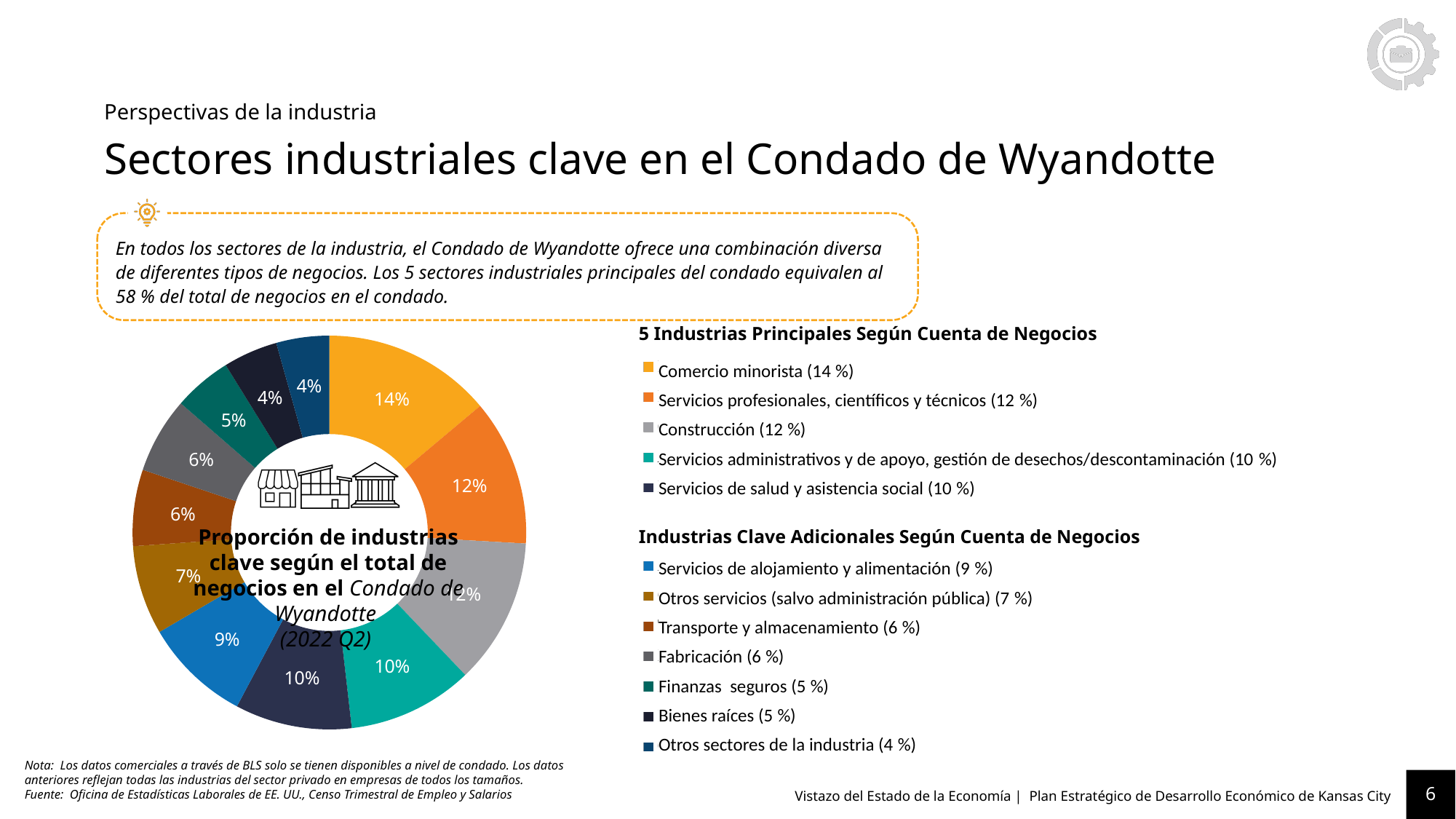
What is the heading of the legend group listing the top five industries? 5 Industrias Principales Según Cuenta de Negocios What is the difference in percentage points between Comercio minorista and Servicios profesionales, científicos y técnicos? 2 percentage points What share of businesses does Comercio minorista represent in the chart? 14% Which industry has the largest slice in the chart? Comercio minorista What percentage is shown for Transporte y almacenamiento? 6% Which is larger, the slice for Servicios administrativos y de apoyo or the slice for Finanzas seguros? Servicios administrativos y de apoyo What period does the chart title say the data is from? 2022 Q2 What percentage is shown for Construcción? 12% What percentage is shown for Otros servicios (salvo administración pública)? 7% How many slices does the donut chart have? 12 What kind of chart is shown on the slide? Pie (donut) chart What percentage is shown for Servicios de alojamiento y alimentación? 9%